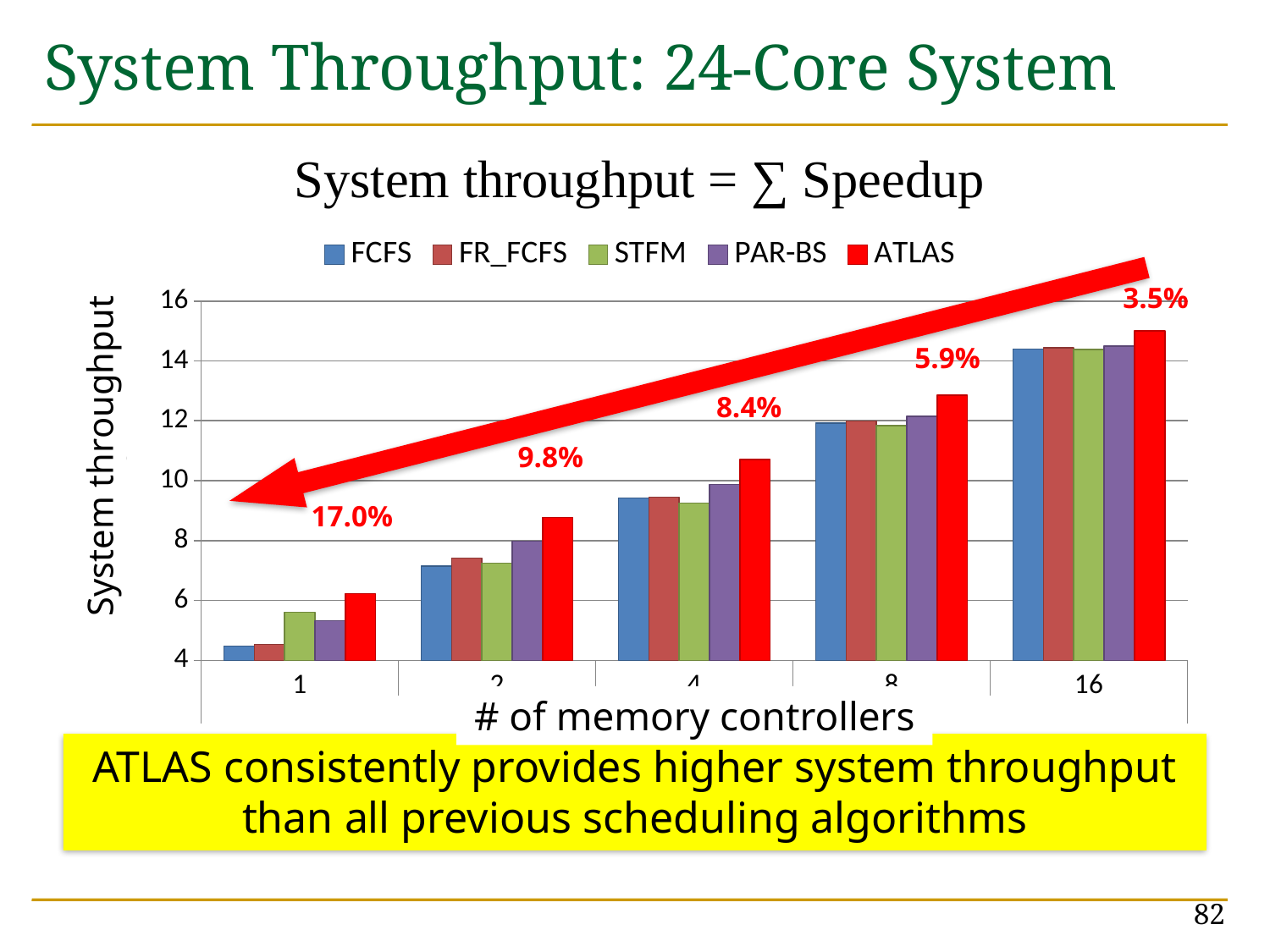
How many memory-controller categories are plotted along the x axis? 5 Does system throughput rise or fall as the number of memory controllers increases? rise What kind of chart is shown on the slide? bar chart What percentage label is printed above the bars for 16 memory controllers? 3.5% What percentage label is printed above the bars for 1 memory controller? 17.0% At 1 memory controller, which is larger: the STFM bar or the FCFS bar? STFM Which series has the highest bar at 16 memory controllers? ATLAS Is the value for FCFS at 1 memory controller greater or less than 6? less Is the value for ATLAS at 16 memory controllers greater or less than 14? greater At which number of memory controllers is the ATLAS bar the lowest? 1 What is the title of the x axis? # of memory controllers How many series does the legend list? 5